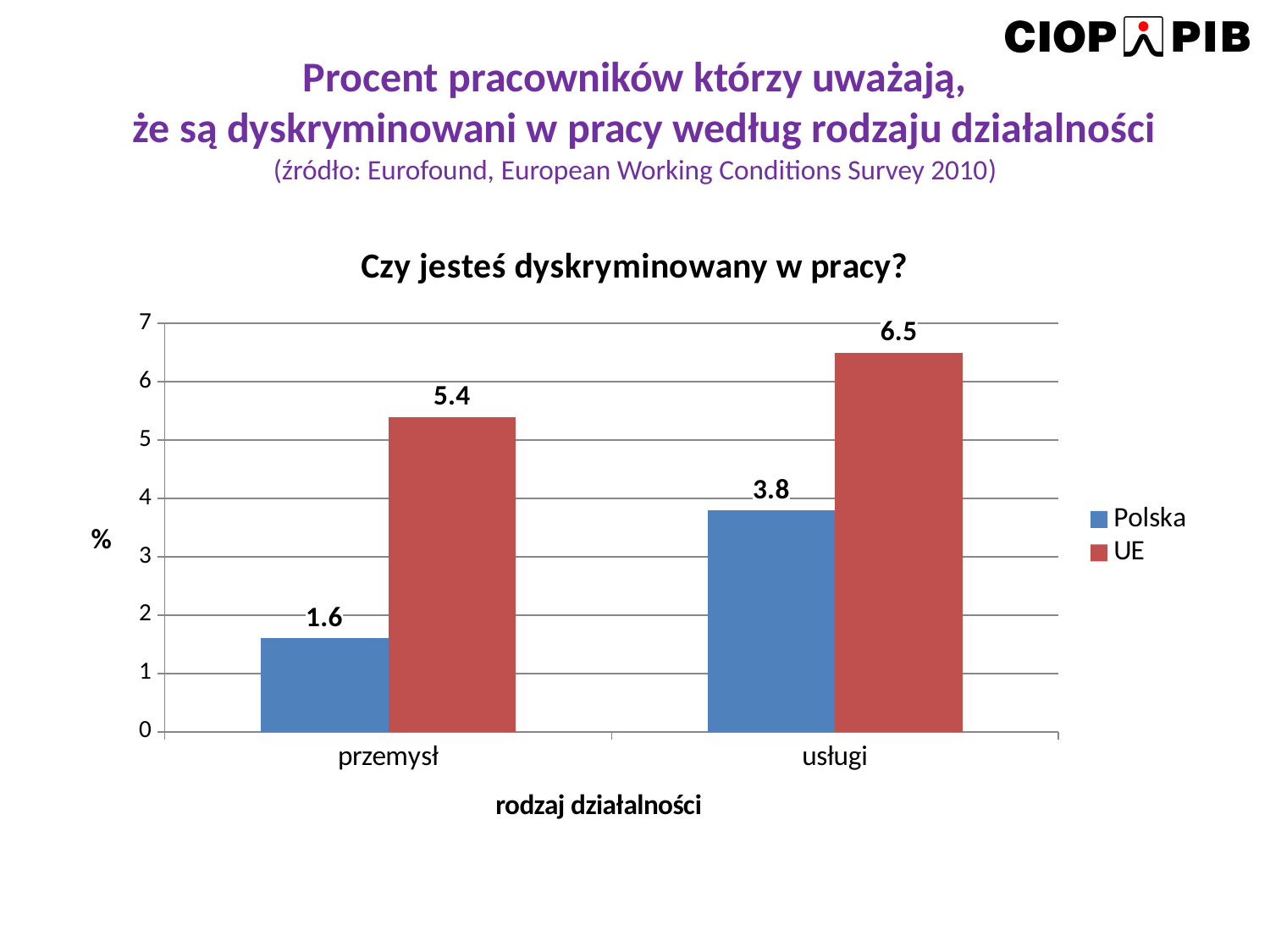
How many series does the legend list? 2 What is the difference between the UE and Polska values in the usługi category? 2.7 What is the value for UE in the usługi category? 6.5 What is the difference between the Polska values for usługi and przemysł? 2.2 What kind of chart is shown on the slide? bar chart What is the value for Polska in the przemysł category? 1.6 What is the value for UE in the przemysł category? 5.4 Which category has the highest value for the UE series? usługi How many categories are shown on the x axis? 2 What is the value for Polska in the usługi category? 3.8 Which category has the lowest value for the Polska series? przemysł Which is larger in the przemysł category, Polska or UE? UE